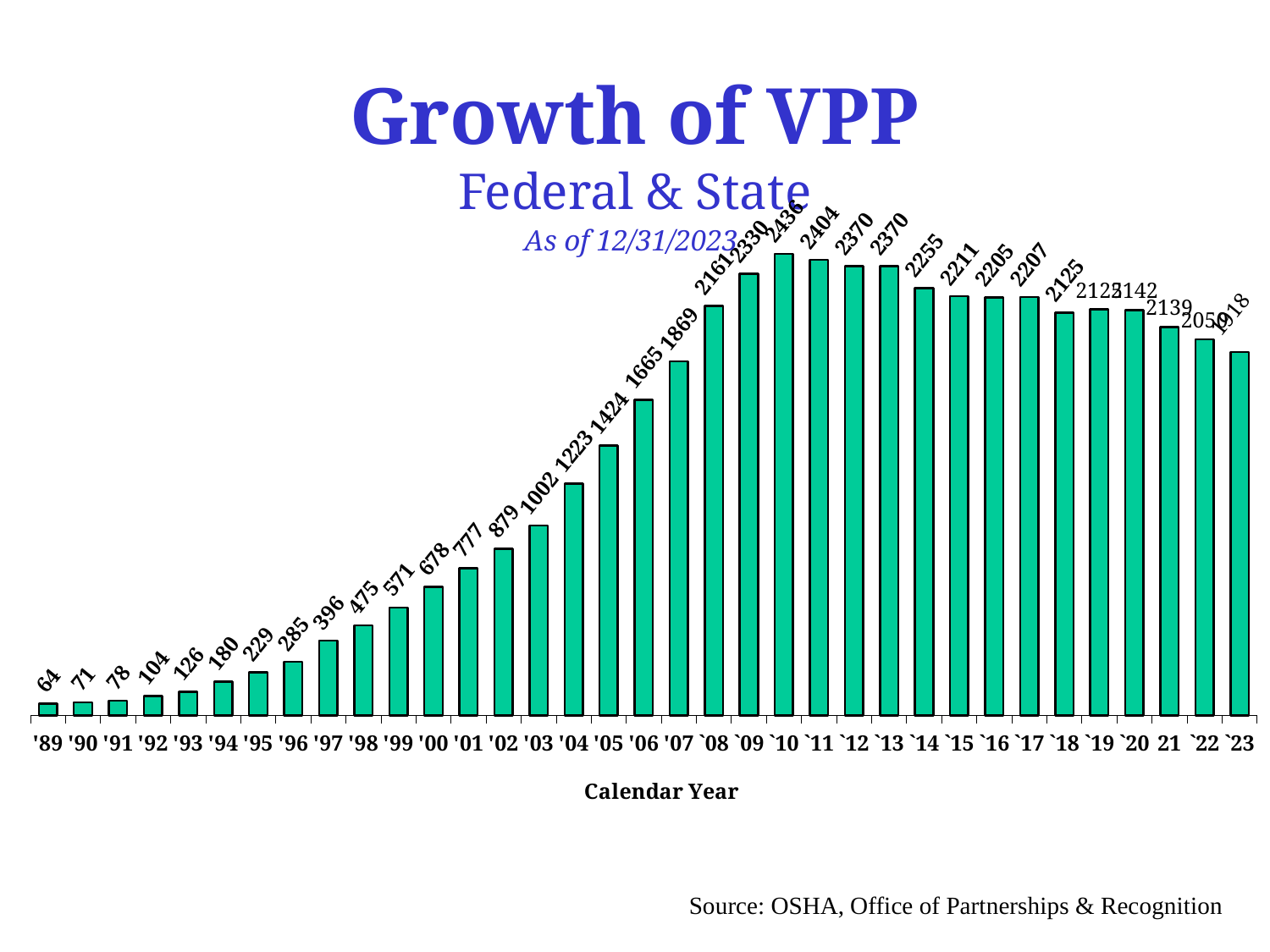
Do the values rise or fall from '89 to '10? rise What is the value for '17? 2207 What is the value for '05? 1424 What is the difference between the values for '10 and '11? 32 What is the difference between the values for '94 and '93? 54 What is the x-axis title? Calendar Year What is the value for '89? 64 Which year has the lowest value? '89 Which is larger, the value for '12 or the value for '14? '12 What kind of chart is this? bar chart How many years are shown on the x axis? 35 Which year has the highest value? '10